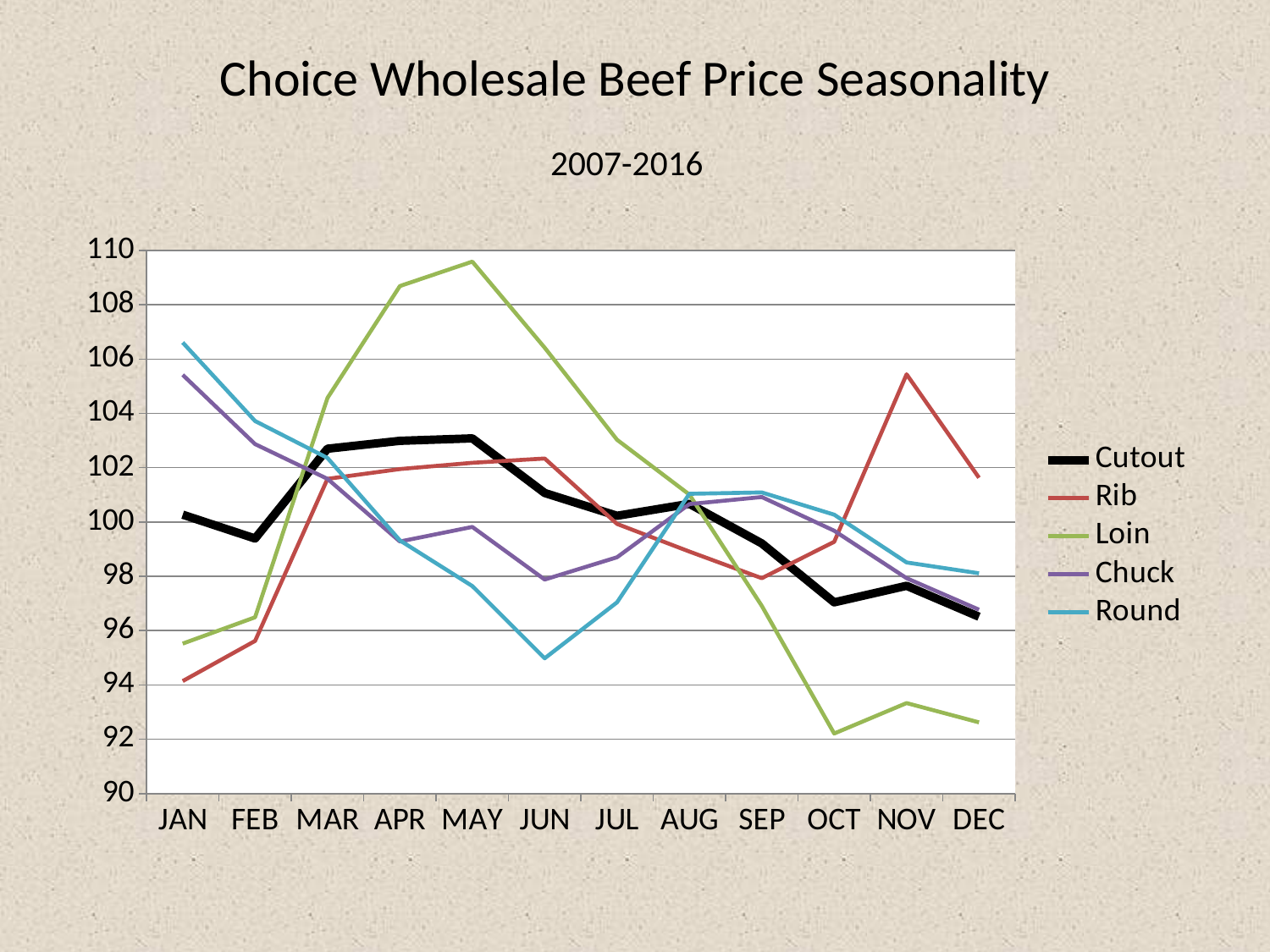
Is the value for Loin in MAY greater or less than 108? greater Which series has the highest value in NOV? Rib How many months are shown along the x axis? 12 How many series does the legend list? 5 Which series is drawn with the thick black line? Cutout Is the value for Rib in JAN greater or less than 96? less Which series has the lowest value in OCT? Loin In JAN, which is larger, the value for Round or the value for Rib? Round Which series has the highest value in MAY? Loin Is the value for Round in JUN greater or less than 96? less Does the Loin series rise or fall from MAY to OCT? fall What kind of chart is shown on the slide? line chart